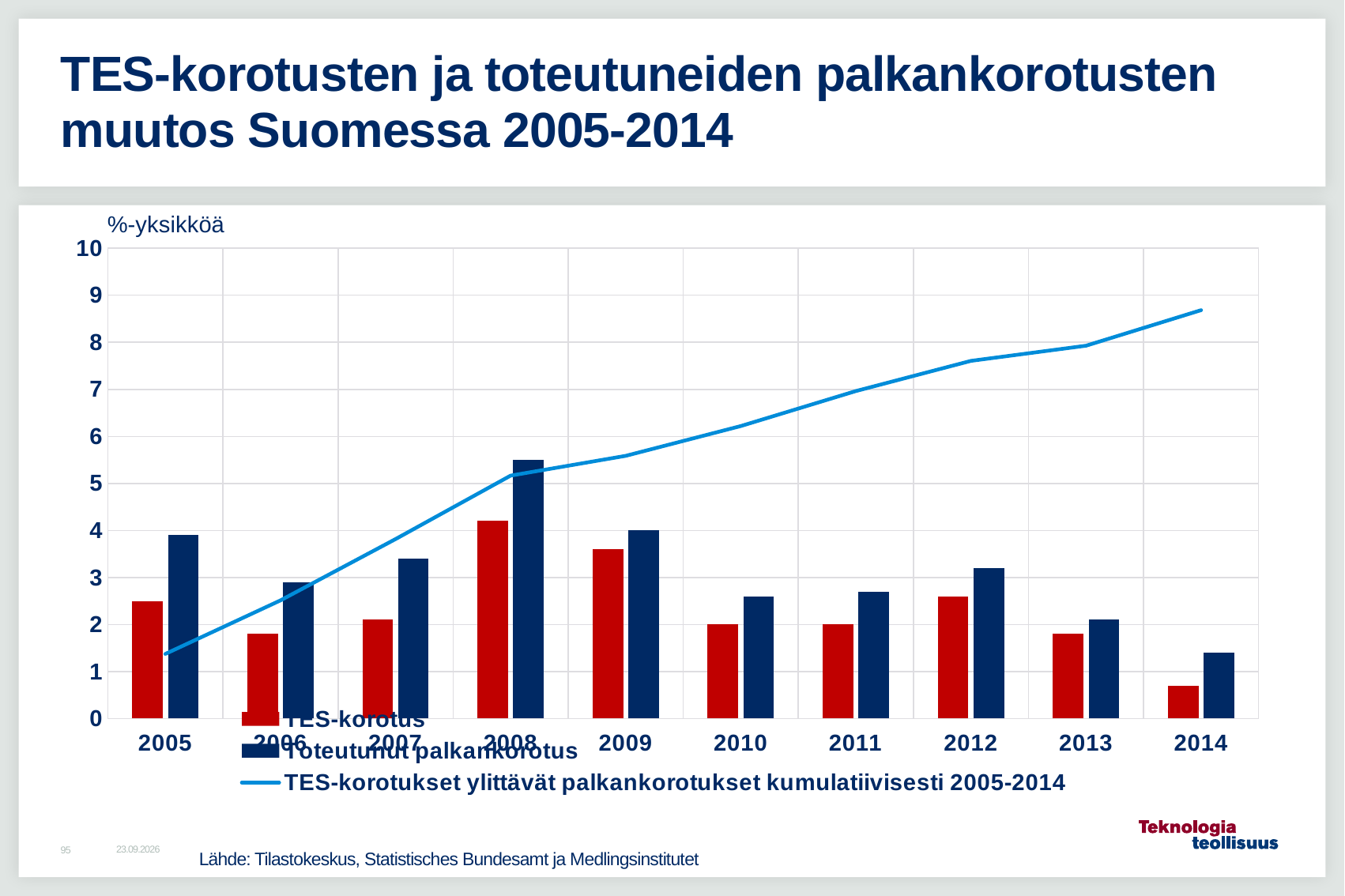
In which year is the Toteutunut palkankorotus bar lowest? 2014 Is the TES-korotus value for 2014 greater or less than 1? less What kind of chart is shown on the slide? A bar chart combined with a line Which is larger, the TES-korotus value for 2008 or for 2009? 2008 How many years are shown on the x axis? 10 How many series does the legend list? 3 In which year is the Toteutunut palkankorotus bar highest? 2008 What unit label is shown above the y axis? %-yksikköä Is the Toteutunut palkankorotus value for 2005 greater or less than 3? greater Does the line for TES-korotukset ylittävät palkankorotukset kumulatiivisesti rise or fall from 2005 to 2014? rise In which year is the TES-korotus bar lowest? 2014 In which year is the TES-korotus bar highest? 2008